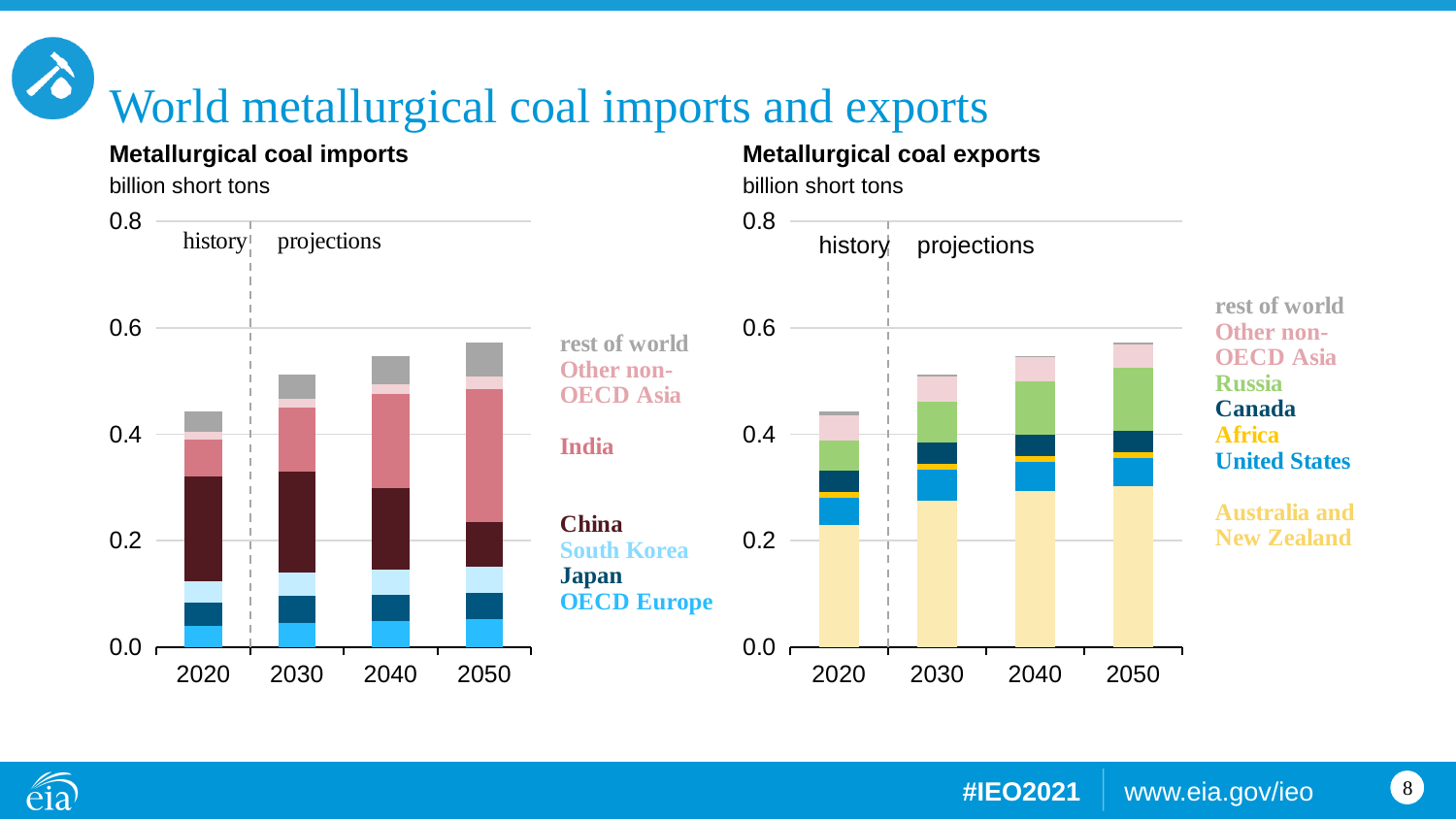
In the Metallurgical coal exports chart, which year has the lowest total bar? 2020 How many series does the legend of the Metallurgical coal exports chart list? 7 In the Metallurgical coal imports chart, is the total for 2020 greater or less than 0.4? greater How many series does the legend of the Metallurgical coal imports chart list? 7 How many years are shown on the x axis of the Metallurgical coal exports chart? 4 In the Metallurgical coal exports chart, is the total for 2050 greater or less than 0.6? less In the Metallurgical coal imports chart, is the China segment larger in 2020 or in 2050? 2020 Do the total bars in the Metallurgical coal exports chart rise or fall from 2020 to 2050? rise What kind of chart is the Metallurgical coal imports chart? stacked bar chart In the Metallurgical coal imports chart, which year has the highest total bar? 2050 What unit is given under the title of the Metallurgical coal imports chart? billion short tons In the Metallurgical coal imports chart, is the India segment larger in 2020 or in 2050? 2050